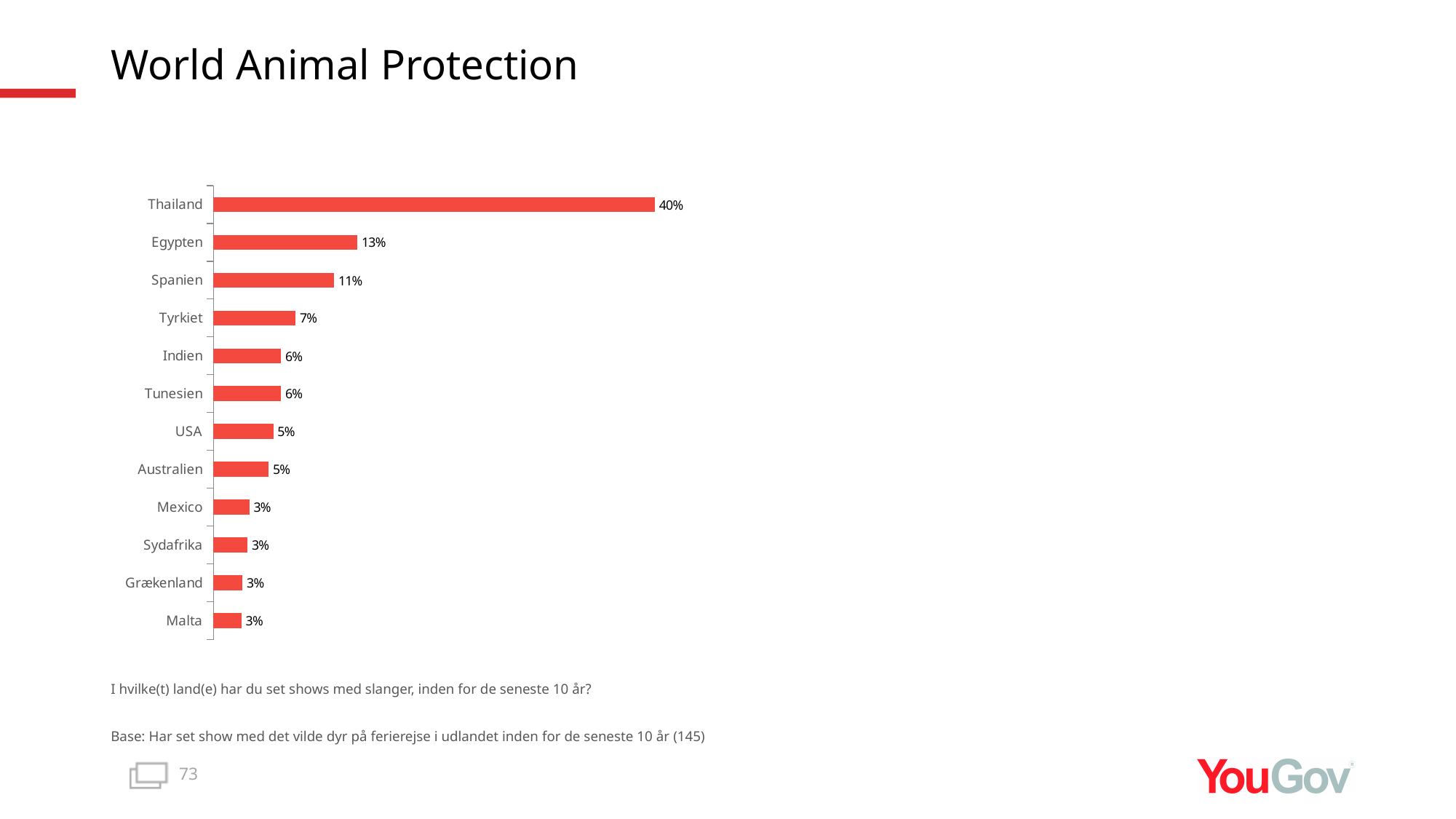
Which has a larger value, Egypten or Spanien? Egypten What is the value for Australien? 5% What is the difference between the values for Thailand and Egypten? 27% Which has a larger value, Mexico or USA? USA What kind of chart is shown on the slide? Bar chart What colour are the bars in the chart? Red What is the value for Tyrkiet? 7% How many countries are shown in the chart? 12 What is the value for Egypten? 13% What is the value for Thailand? 40% What is the difference between the values for Spanien and Tyrkiet? 4% Which country has the highest value? Thailand